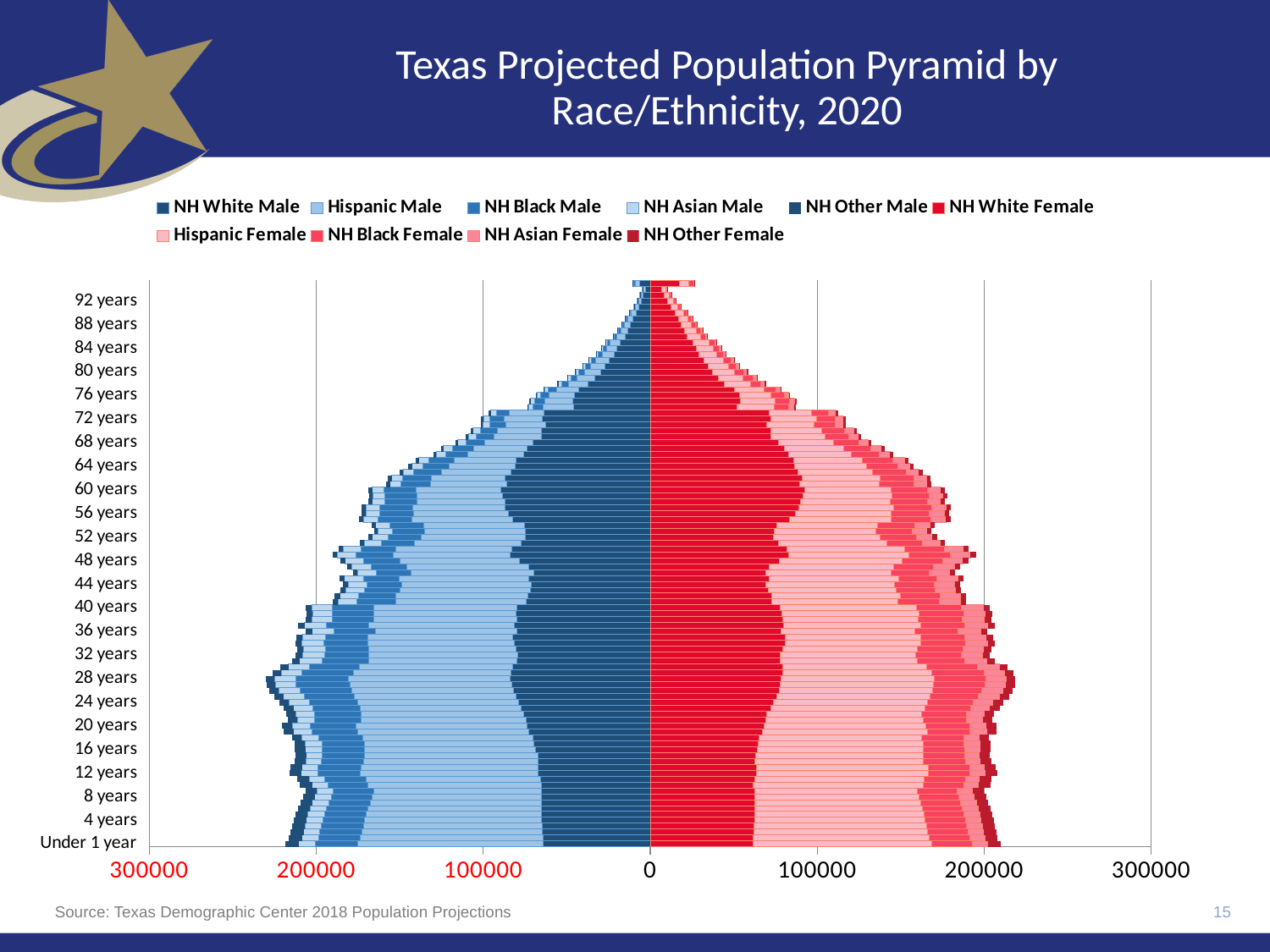
What kind of chart is shown on the slide? bar chart What is the title of the chart? Texas Projected Population Pyramid by Race/Ethnicity, 2020 Moving up the chart from 60 years to 92 years, do the bars get longer or shorter? shorter Is the total length of the male (left) bar for 60 years greater or less than 100000? greater Is the total length of the male (left) bar for 92 years greater or less than 100000? less Is the total length of the male (left) bar for 28 years greater or less than 200000? greater How many age labels are shown on the vertical axis? 24 What is the source cited below the chart? Texas Demographic Center 2018 Population Projections Which is longer, the male (left) bar for 28 years or the male (left) bar for 84 years? 28 years How many series does the legend list? 10